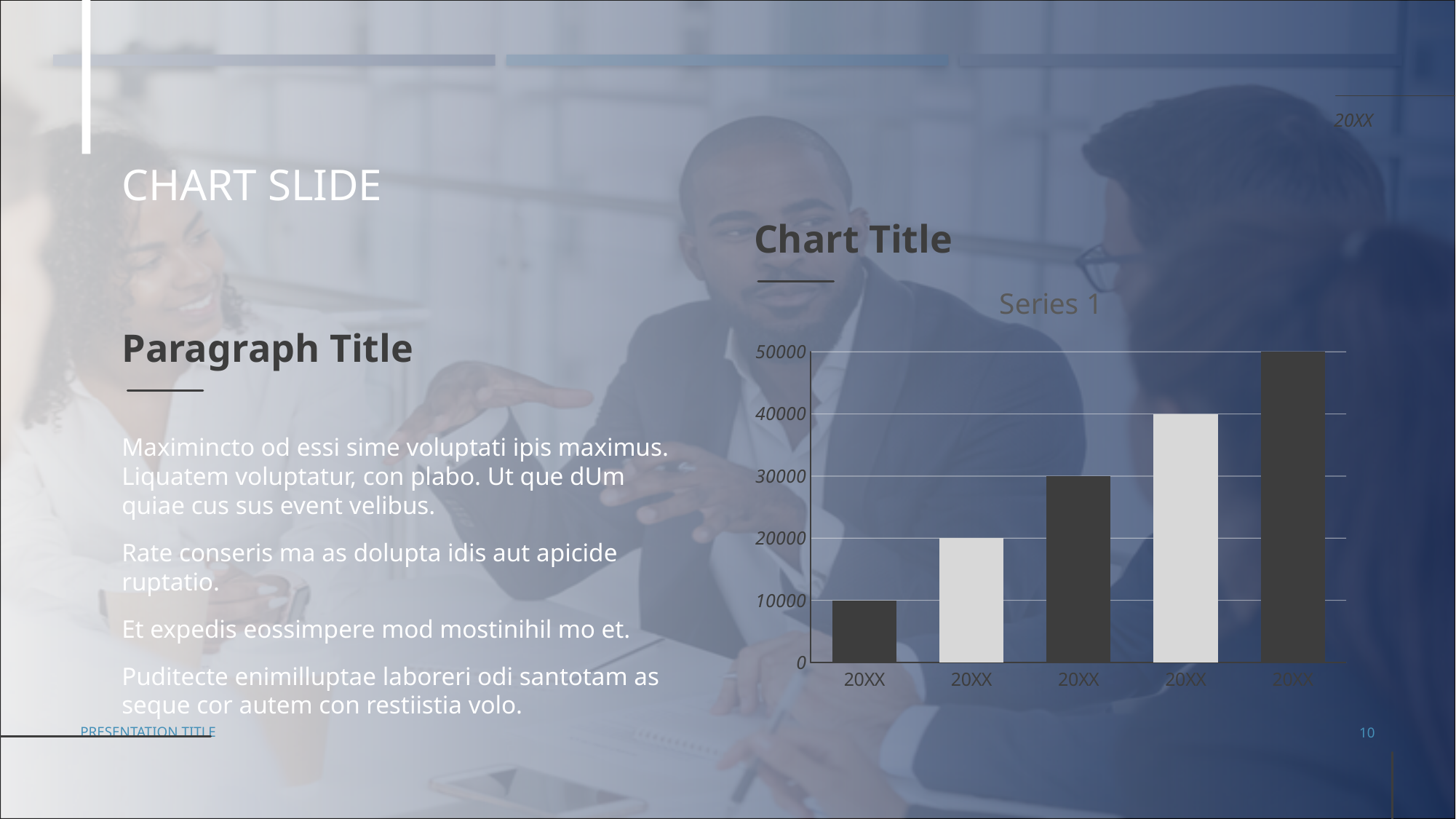
What is the title of the chart? Chart Title What is the value of the first (leftmost) bar in the chart? 10000 Which bar has the lowest value in the chart? the first (leftmost) bar Do the bar values rise or fall from left to right along the x axis? rise What is the value of the last (rightmost) bar in the chart? 50000 Which bar has the highest value in the chart? the fifth (rightmost) bar What kind of chart is shown on the slide? bar chart How many bars are plotted in the chart? 5 What is the difference between the value of the fourth bar and the value of the second bar? 20000 What is the value of the third bar from the left in the chart? 30000